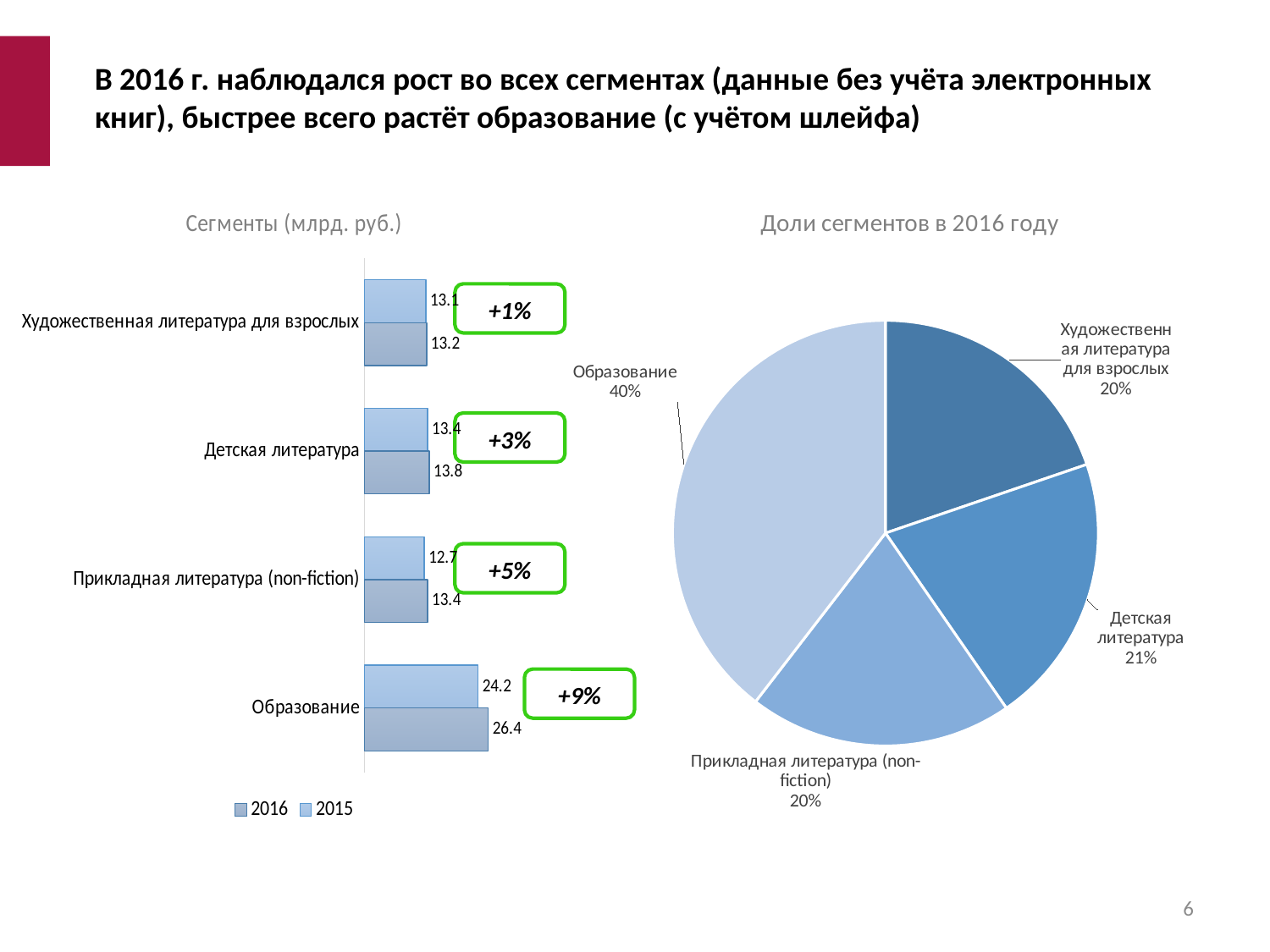
In the chart 'Сегменты (млрд. руб.)', how many categories are shown? 4 In the chart 'Сегменты (млрд. руб.)', which category has the highest 2016 value? Образование In the chart 'Сегменты (млрд. руб.)', what is the difference between the 2016 and 2015 values for Образование? 2.2 In the chart 'Сегменты (млрд. руб.)', what is the 2016 value for Образование? 26.4 In the chart 'Сегменты (млрд. руб.)', what is the 2016 value for Прикладная литература (non-fiction)? 13.4 In the pie chart 'Доли сегментов в 2016 году', which segment has the largest share? Образование In the chart 'Сегменты (млрд. руб.)', which category has the lowest 2015 value? Прикладная литература (non-fiction) What kind of chart is 'Сегменты (млрд. руб.)'? bar chart In the chart 'Сегменты (млрд. руб.)', how many series does the legend list? 2 In the pie chart 'Доли сегментов в 2016 году', what share does Образование have? 40% In the pie chart 'Доли сегментов в 2016 году', what share does Детская литература have? 21% In the chart 'Сегменты (млрд. руб.)', what is the 2015 value for Детская литература? 13.4